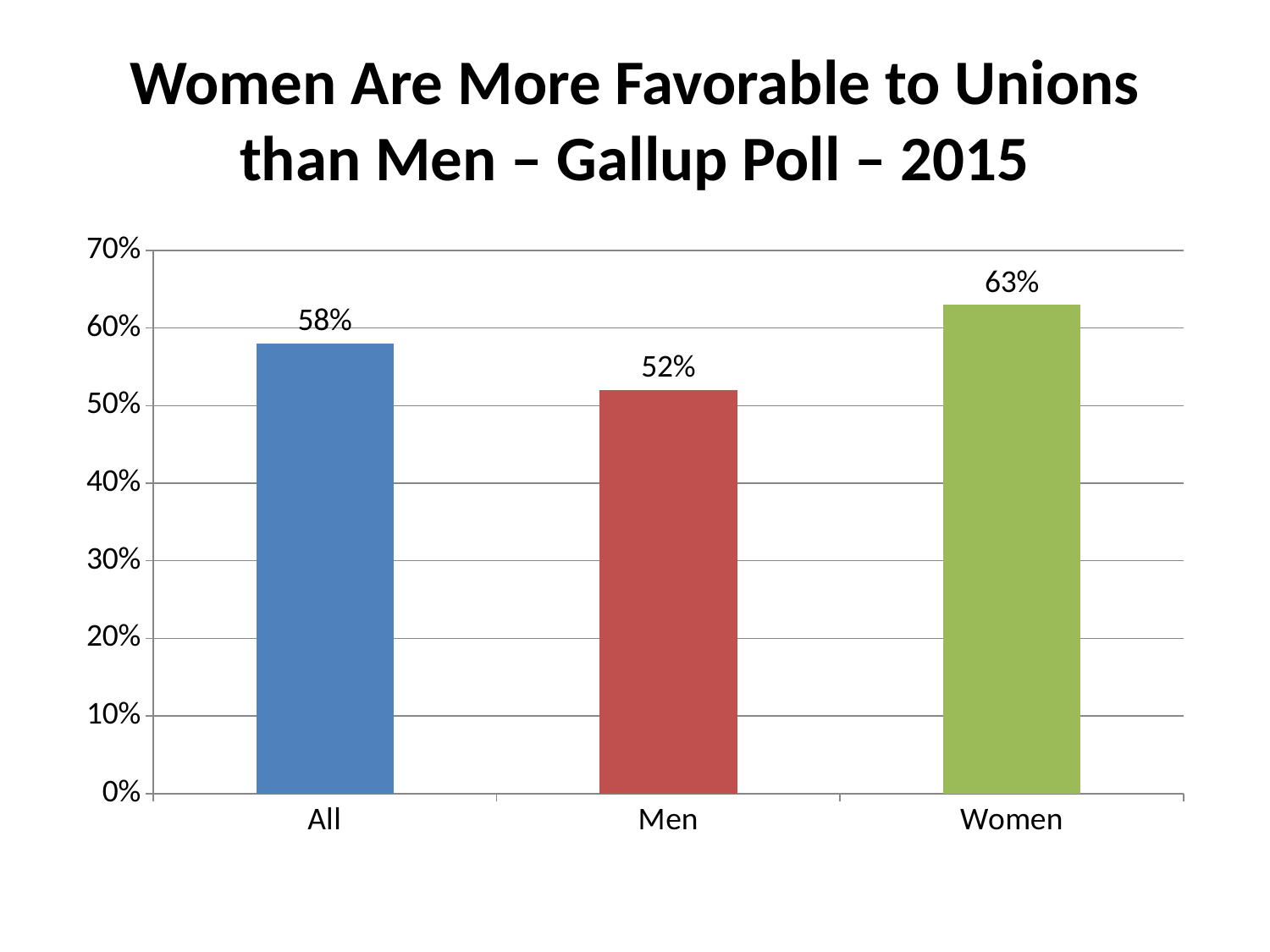
Which category has the highest value? Women What kind of chart is shown on the slide? bar chart What is the difference between the values for Women and Men? 11% What is the value for Men? 52% What is the difference between the values for All and Men? 6% Which is larger, the value for All or the value for Men? All What is the value for Women? 63% What colour is the bar for Women? green How many categories are shown on the x axis? 3 What is the value for All? 58% Which category has the lowest value? Men Is the value for Women greater or less than 60%? greater